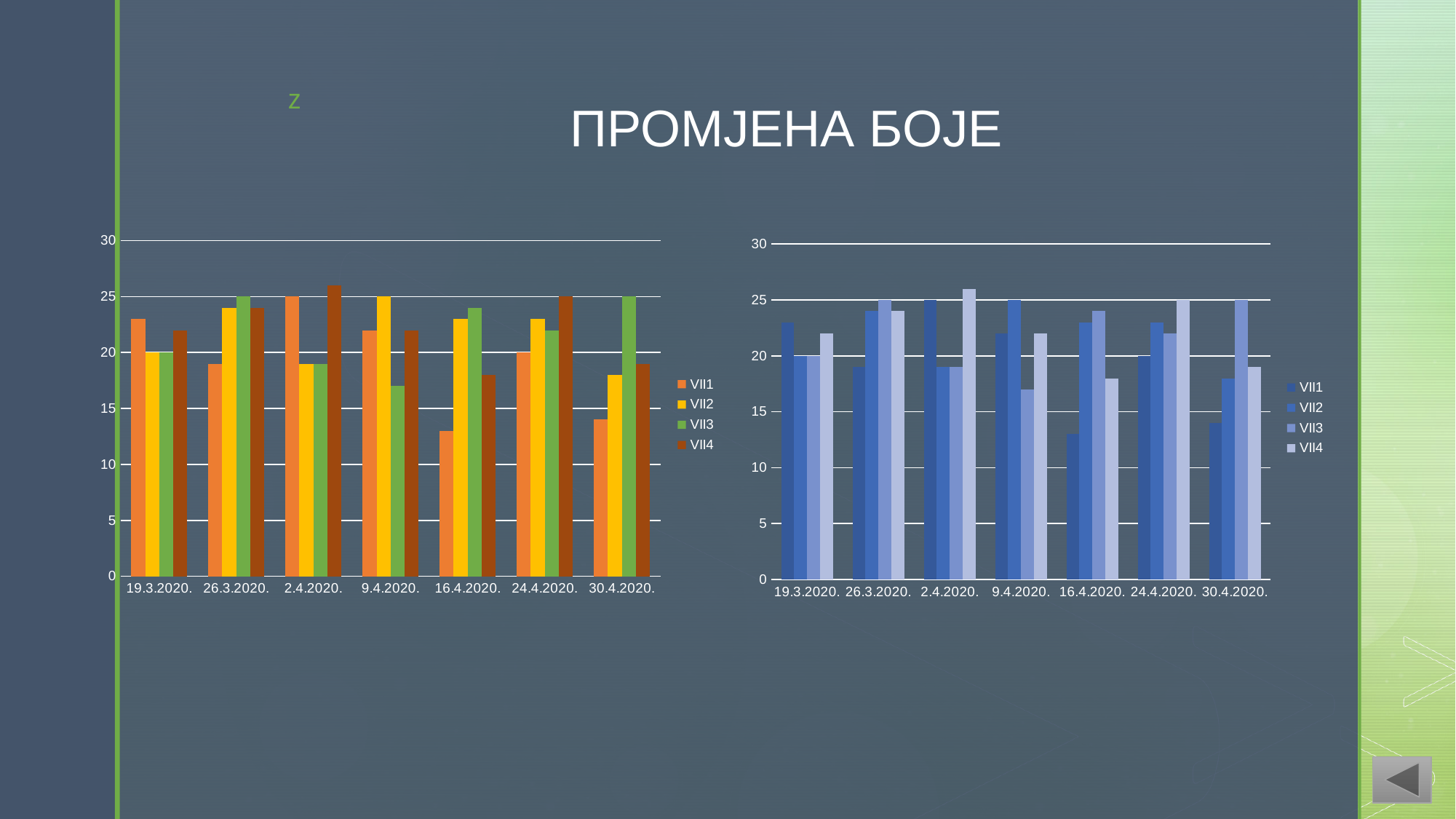
In the left chart, which series has the lowest value on 16.4.2020.? VII1 In the left chart, what is the value for VII1 on 2.4.2020.? 25 How many series does the legend of the left chart list? 4 In the right chart, is the value for VII4 on 2.4.2020. greater or less than 25? greater What are the legend entries of the right chart? VII1, VII2, VII3, VII4 What kind of chart is the left chart on the slide? bar chart What is the title of the slide? ПРОМЈЕНА БОЈЕ In the right chart, is the value for VII3 on 9.4.2020. greater or less than 20? less In the left chart, is the value for VII1 on 16.4.2020. greater or less than 15? less In the right chart, what is the value for VII2 on 9.4.2020.? 25 How many dates are shown on the x axis of the right chart? 7 In the left chart, which is larger on 30.4.2020., VII1 or VII3? VII3